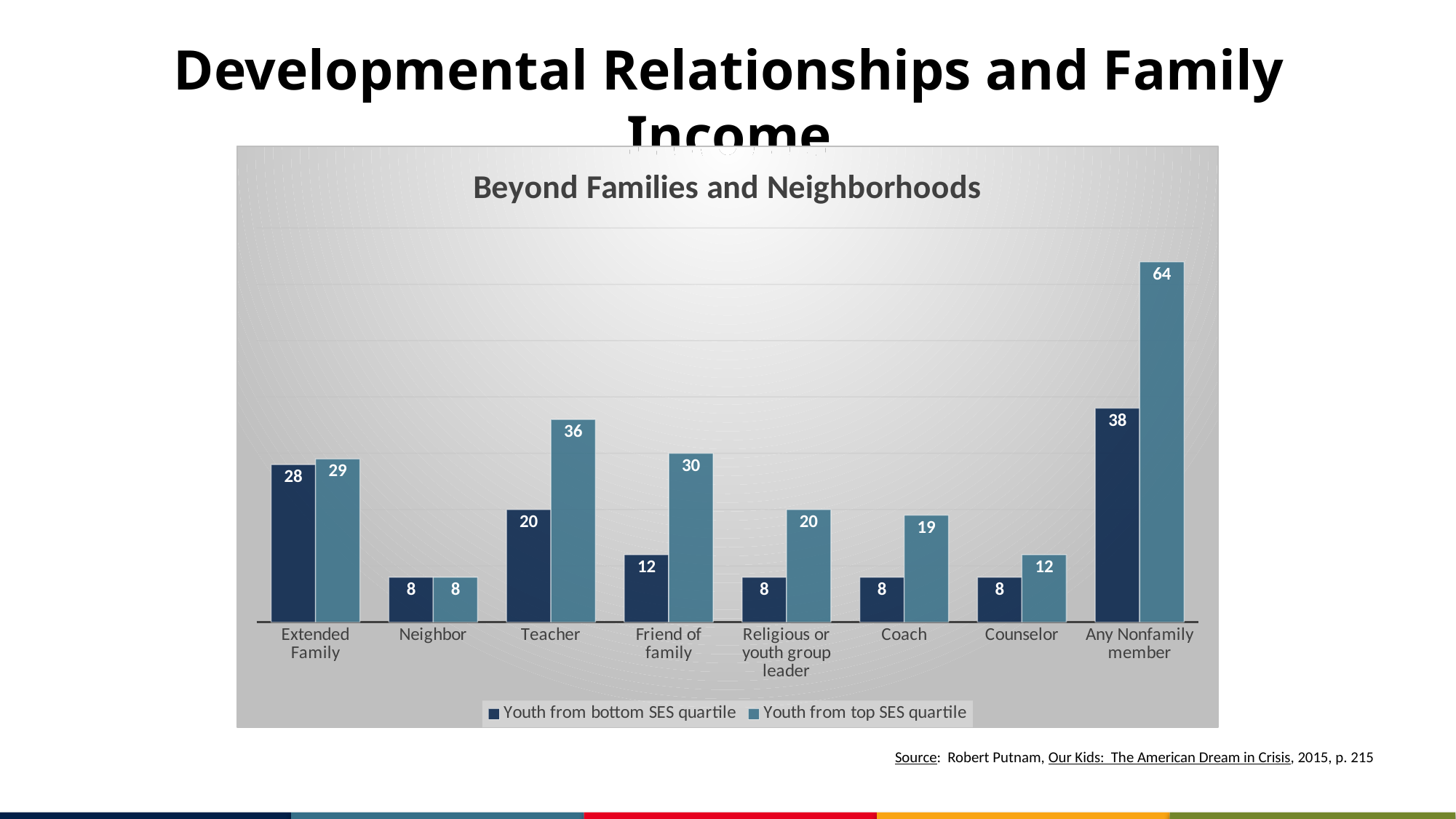
What is the value for Friend of family for Youth from bottom SES quartile? 12 How many series does the legend list? 2 How many categories are shown on the x axis? 8 Which category has the highest value for Youth from top SES quartile? Any Nonfamily member What is the value for Teacher for Youth from top SES quartile? 36 What is the difference between the top and bottom SES quartile values for Religious or youth group leader? 12 What is the difference between the top SES quartile and bottom SES quartile values for Any Nonfamily member? 26 Which is larger for Teacher: Youth from bottom SES quartile or Youth from top SES quartile? Youth from top SES quartile What is the title of the chart? Beyond Families and Neighborhoods What is the value for Coach for Youth from top SES quartile? 19 Which category has the lowest value for Youth from top SES quartile? Neighbor What kind of chart is shown? Bar chart